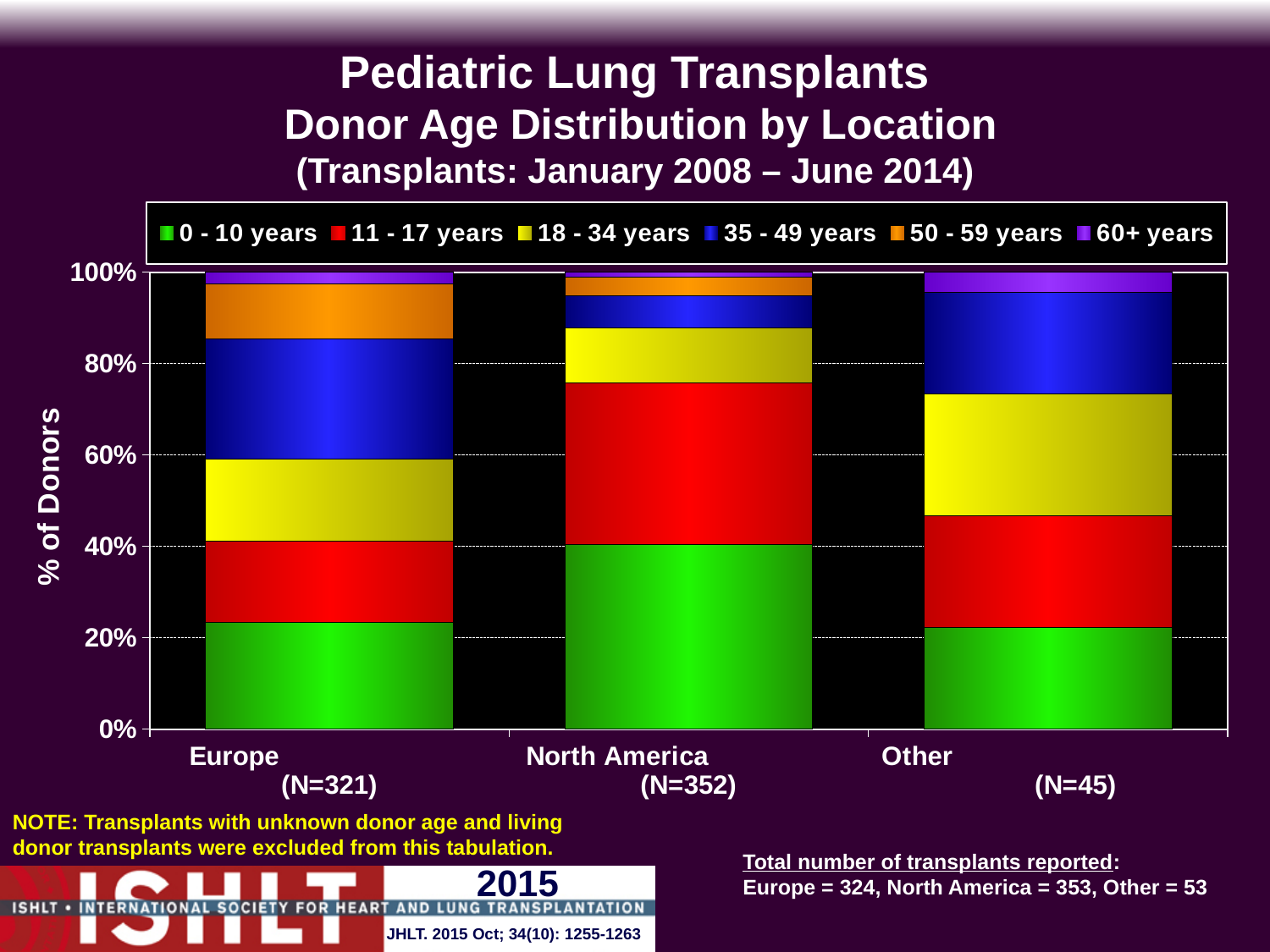
Is the share of 0 - 10 years donors for North America greater or less than 20%? greater How many locations are shown along the x axis? 3 What is the N value shown under the Europe bar? N=321 Is the 35 - 49 years donor share larger for Europe or for North America? Europe How many donor age groups does the legend list? 6 Is the 0 - 10 years donor share larger for Europe or for North America? North America Is the share of 0 - 10 years donors for Europe greater or less than 40%? less What colour represents the 35 - 49 years age group in the legend? Blue Is the share of 0 - 10 years donors for Other greater or less than 40%? less Which location has the smallest share of 35 - 49 years donors? North America Which location has the largest share of 0 - 10 years donors? North America What kind of chart is shown on the slide? Stacked bar chart